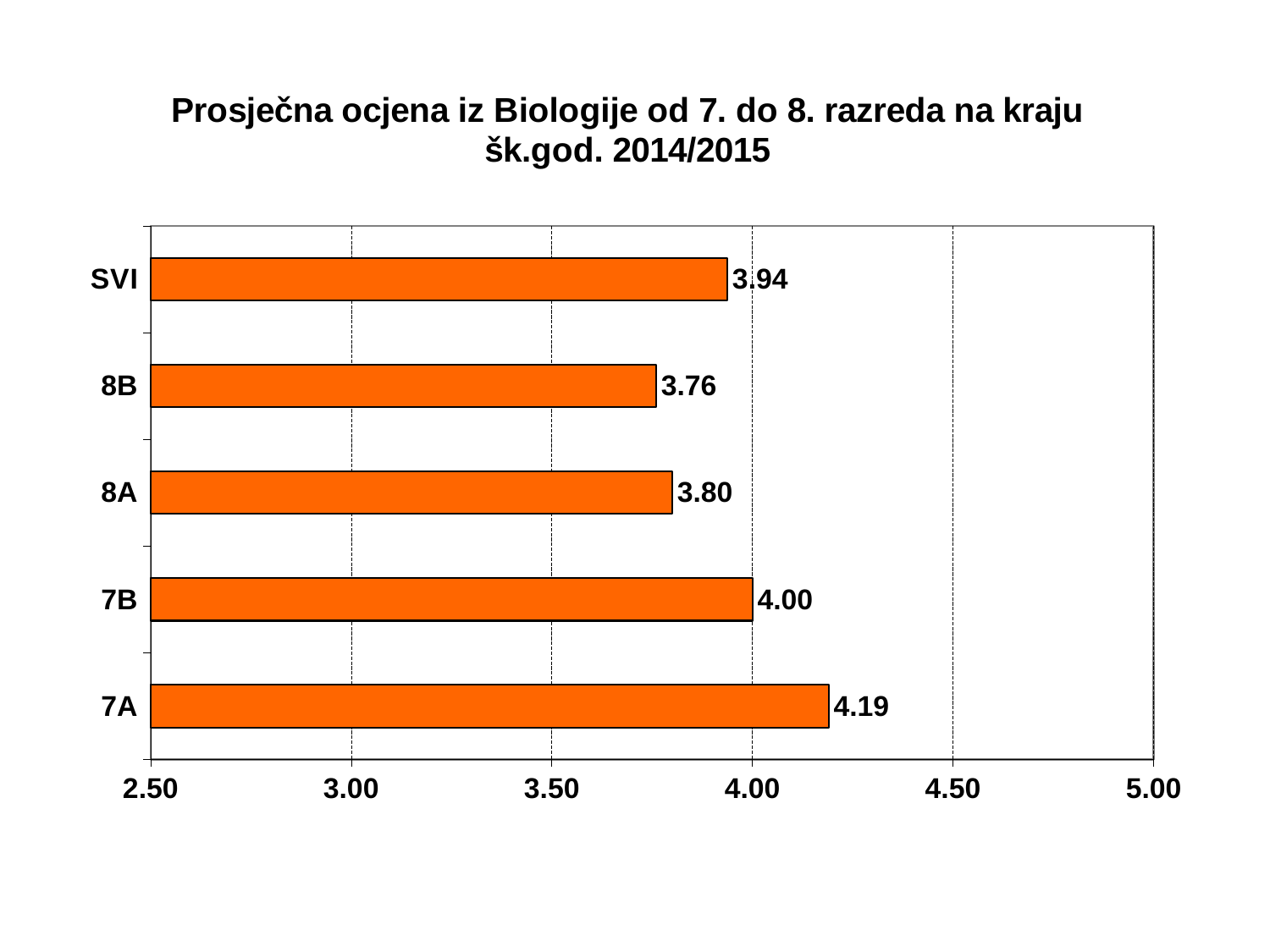
What is the minimum value shown on the horizontal axis? 2.50 Which category has the lowest value on the chart? 8B What kind of chart is shown on the slide? bar chart What is the value shown for SVI? 3.94 Which has a higher average grade, 7B or 8A? 7B What is the difference between the values for 8A and 8B? 0.04 What is the average Biology grade for class 7A? 4.19 What is the difference between the values for 7A and 7B? 0.19 Is the value for 8B greater or less than 4.00? less What is the average Biology grade for class 8B? 3.76 How many categories are shown on the chart? 5 Which class has the highest average Biology grade? 7A